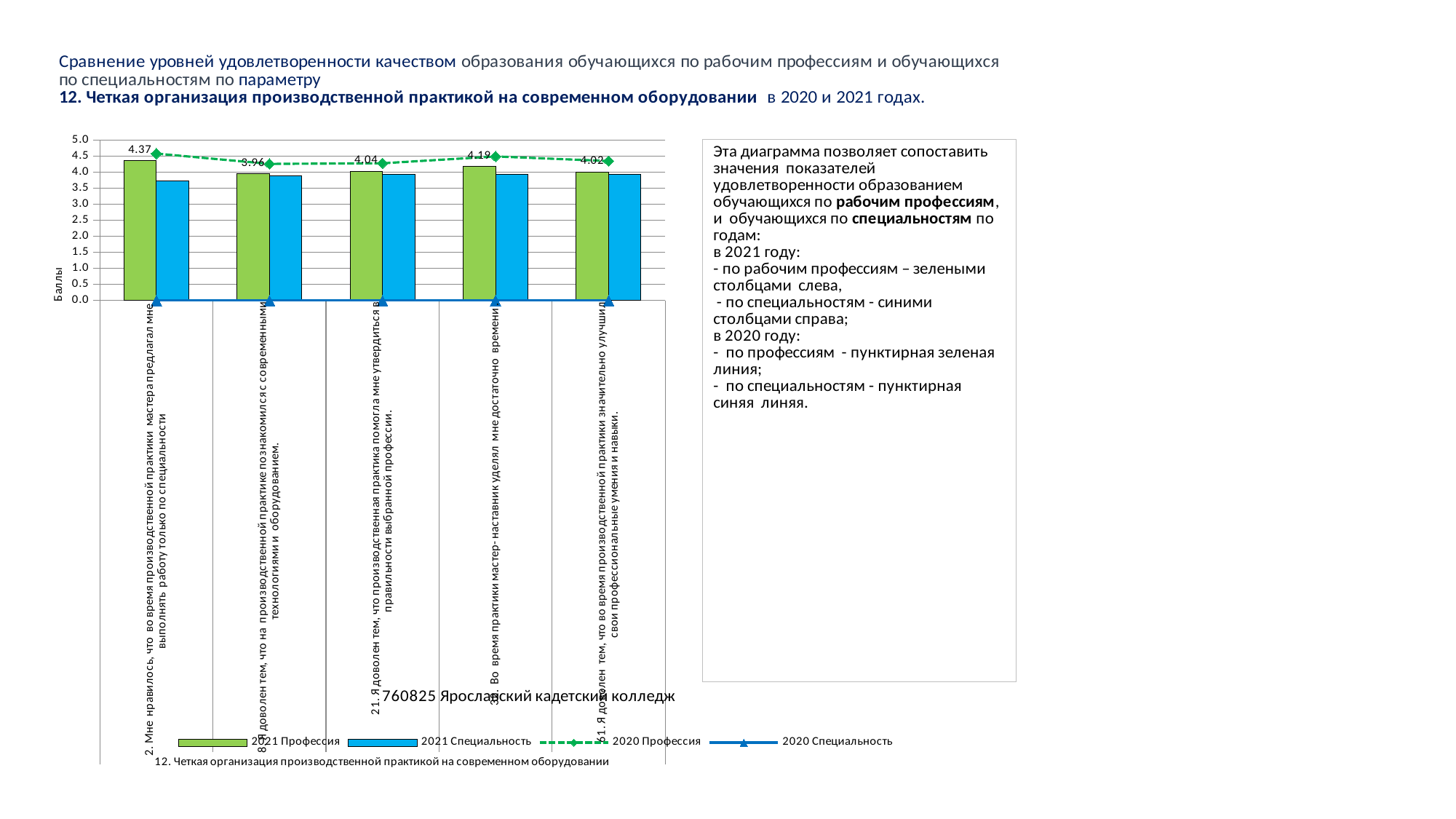
How many series does the legend list? 4 What is the difference between the 2021 Профессия values for question 2 and question 8? 0.41 For question 2, which is larger: the 2021 Профессия bar or the 2021 Специальность bar? 2021 Профессия What is the 2021 Профессия value for question 30 (Во время практики мастер-наставник уделял мне достаточно времени)? 4.19 How many categories (questions) are shown on the x axis? 5 What is the 2021 Профессия value for question 8 (Я доволен тем, что на производственной практике познакомился с современными технологиями и оборудованием)? 3.96 Which category has the lowest 2021 Профессия value? 8. Я доволен тем, что на производственной практике познакомился с современными технологиями и оборудованием Is the 2021 Специальность value for question 2 greater or less than 4.0? less What is the difference between the 2021 Профессия values for question 30 and question 21? 0.15 Which category has the highest 2021 Профессия value? 2. Мне нравилось, что во время производственной практики мастера предлагал мне выполнять работу только по специальности What is the 2021 Профессия value for question 2 (Мне нравилось, что во время производственной практики мастера предлагал мне выполнять работу только по специальности)? 4.37 What is the title of the vertical axis? Баллы